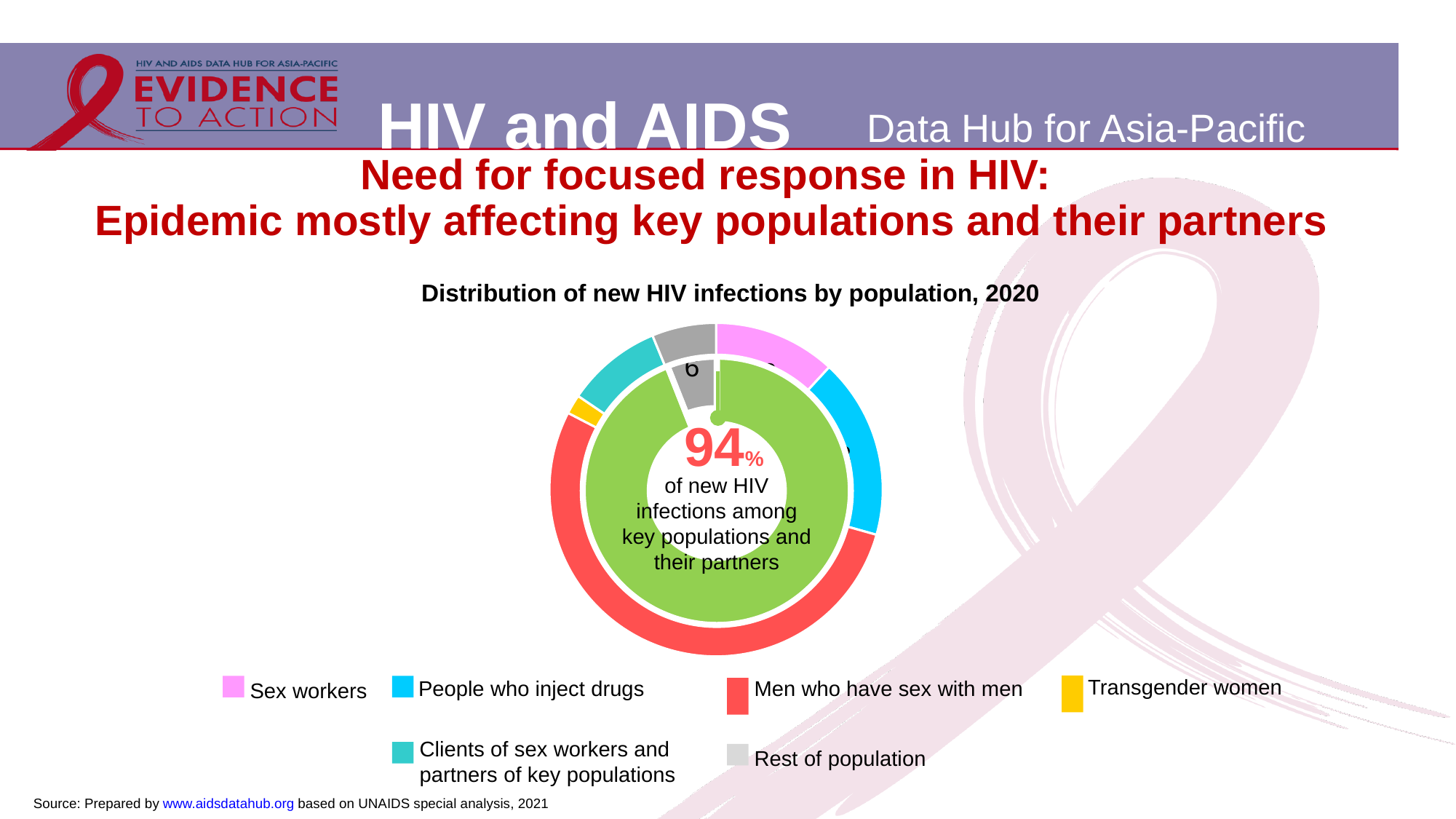
What colour represents Sex workers in the chart? Pink According to the text in the centre of the chart, what share of new HIV infections is among key populations and their partners? 94% Which category is shown in grey in the chart? Rest of population Which slice is larger: People who inject drugs or Transgender women? People who inject drugs What is the title of the chart? Distribution of new HIV infections by population, 2020 Which population category has the largest slice of the chart? Men who have sex with men Which population category has the smallest slice of the chart? Transgender women Which slice is larger: Rest of population or Men who have sex with men? Men who have sex with men What kind of chart is shown on the slide? Pie chart (donut) How many population categories does the legend list? 6 Which slice is larger: Men who have sex with men or Sex workers? Men who have sex with men